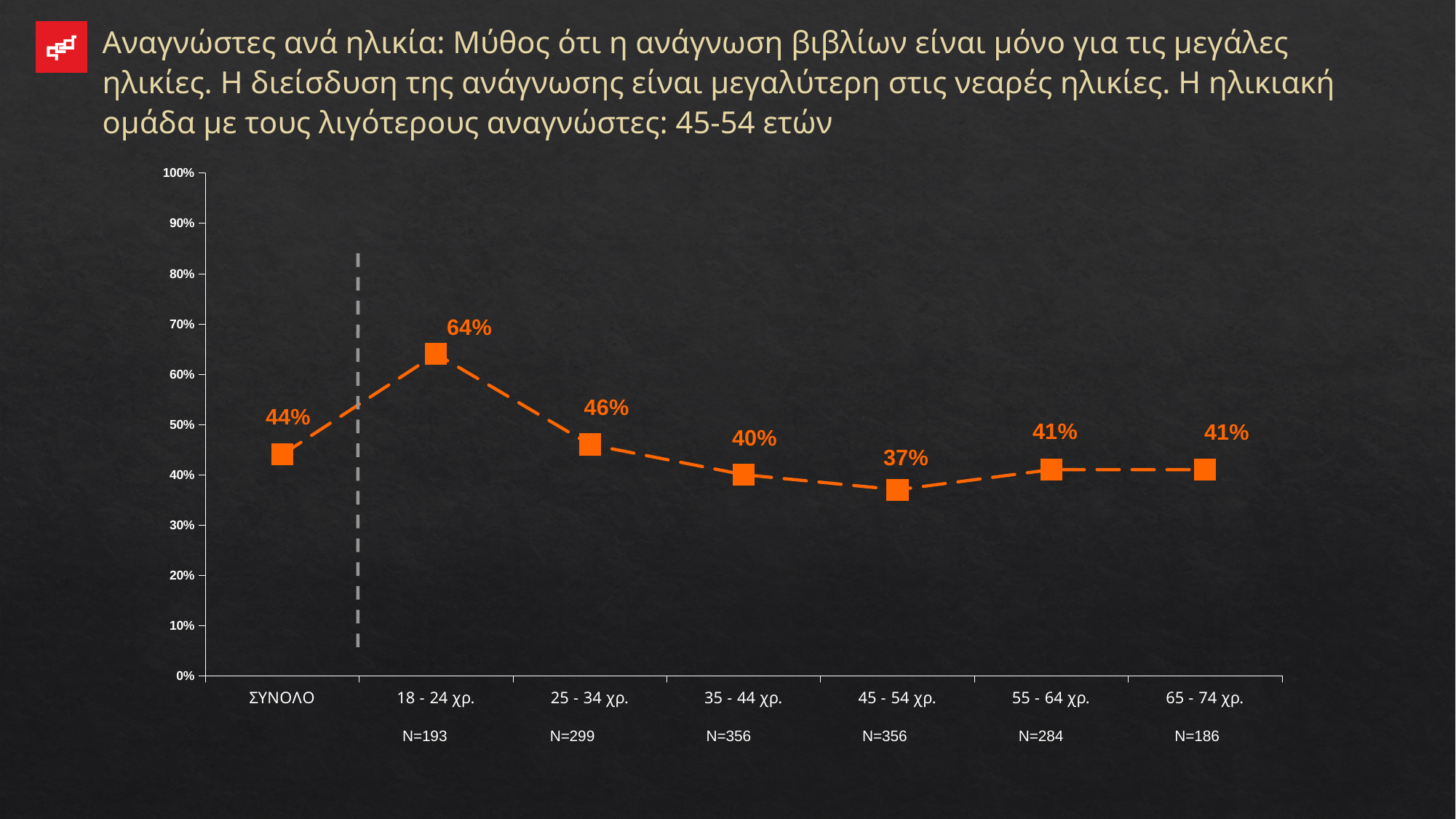
What is the sample size (N) shown for the 25 - 34 χρ. age group? N=299 Which is larger, the value for 25 - 34 χρ. or the value for 55 - 64 χρ.? 25 - 34 χρ. What is the difference between the values for 18 - 24 χρ. and 25 - 34 χρ.? 18% What is the value for the 45 - 54 χρ. age group? 37% What is the value for the 18 - 24 χρ. age group? 64% What is the value for the 35 - 44 χρ. age group? 40% Is the value for 18 - 24 χρ. greater or less than 60%? greater Which age group has the lowest value? 45 - 54 χρ. What is the value for ΣΥΝΟΛΟ? 44% How many categories are plotted on the x axis? 7 Which age group has the highest value? 18 - 24 χρ. What kind of chart is shown on the slide? line chart